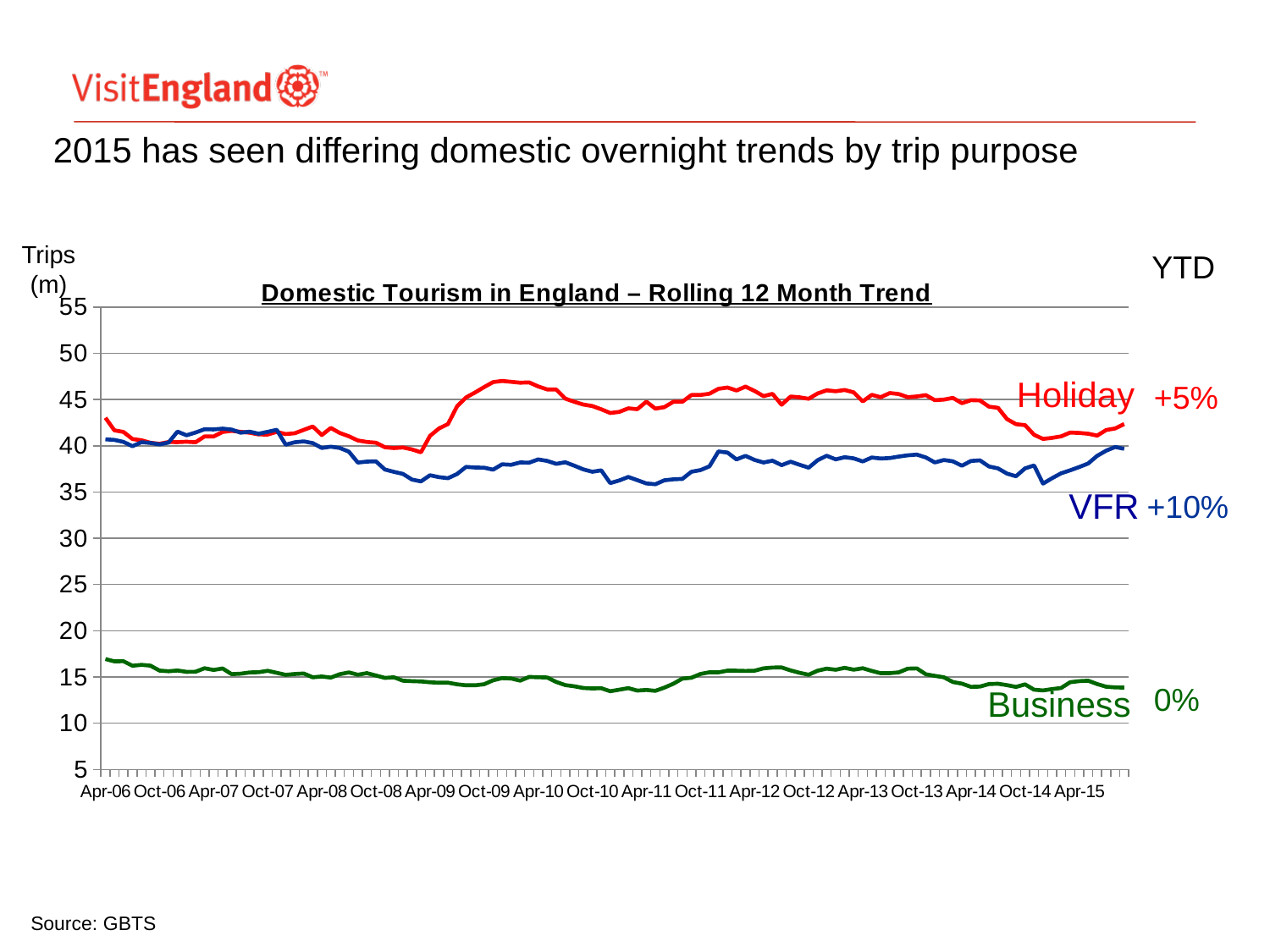
Which trip purpose has the lowest number of trips across the whole period? Business Which trip purpose has the highest number of trips across the whole period? Holiday Is the value for VFR trips at Apr-11 greater or less than 40? less Is the value for Business trips at Apr-15 greater or less than 20? less Do Business trips rise or fall between Apr-06 and Apr-15? fall How many series are plotted on the chart? 3 What kind of chart is shown on the slide? line chart Is the value for Holiday trips at Oct-09 greater or less than 45? greater What is the YTD change shown for Business trips? 0% What is the YTD change shown for Holiday trips? +5% What is the title of the chart? Domestic Tourism in England – Rolling 12 Month Trend What is the YTD change shown for VFR trips? +10%